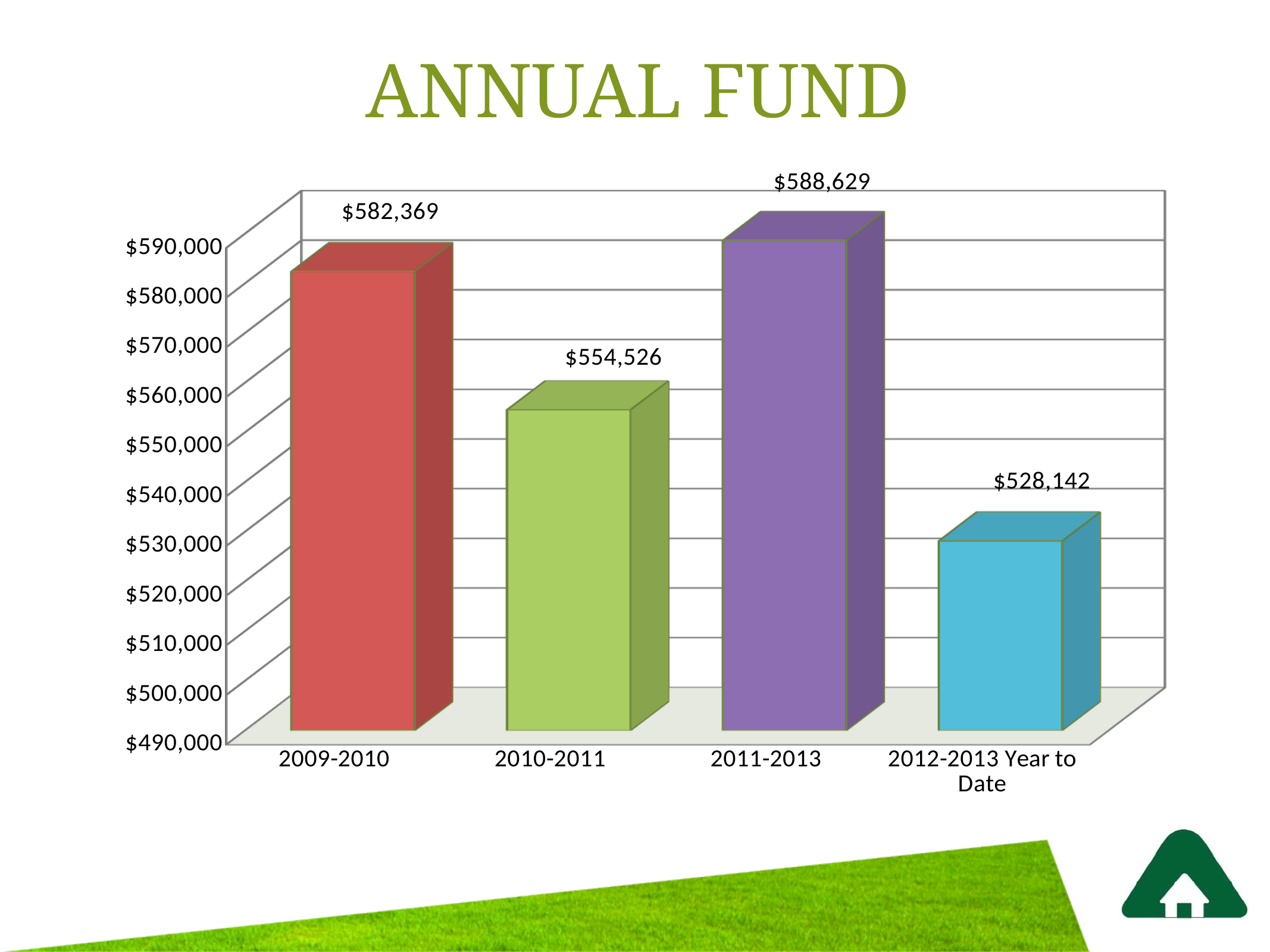
What is the value for 2012-2013 Year to Date? $528,142 Which category has the highest value? 2011-2013 How many categories are shown on the x axis? 4 Which is larger, the value for 2009-2010 or the value for 2010-2011? 2009-2010 What is the difference between the values for 2011-2013 and 2012-2013 Year to Date? $60,487 What kind of chart is shown on the slide? bar chart What is the value for 2010-2011? $554,526 Is the value for 2010-2011 greater or less than $550,000? greater What is the value for 2011-2013? $588,629 Which category has the lowest value? 2012-2013 Year to Date What is the value for 2009-2010? $582,369 What is the difference between the values for 2009-2010 and 2010-2011? $27,843